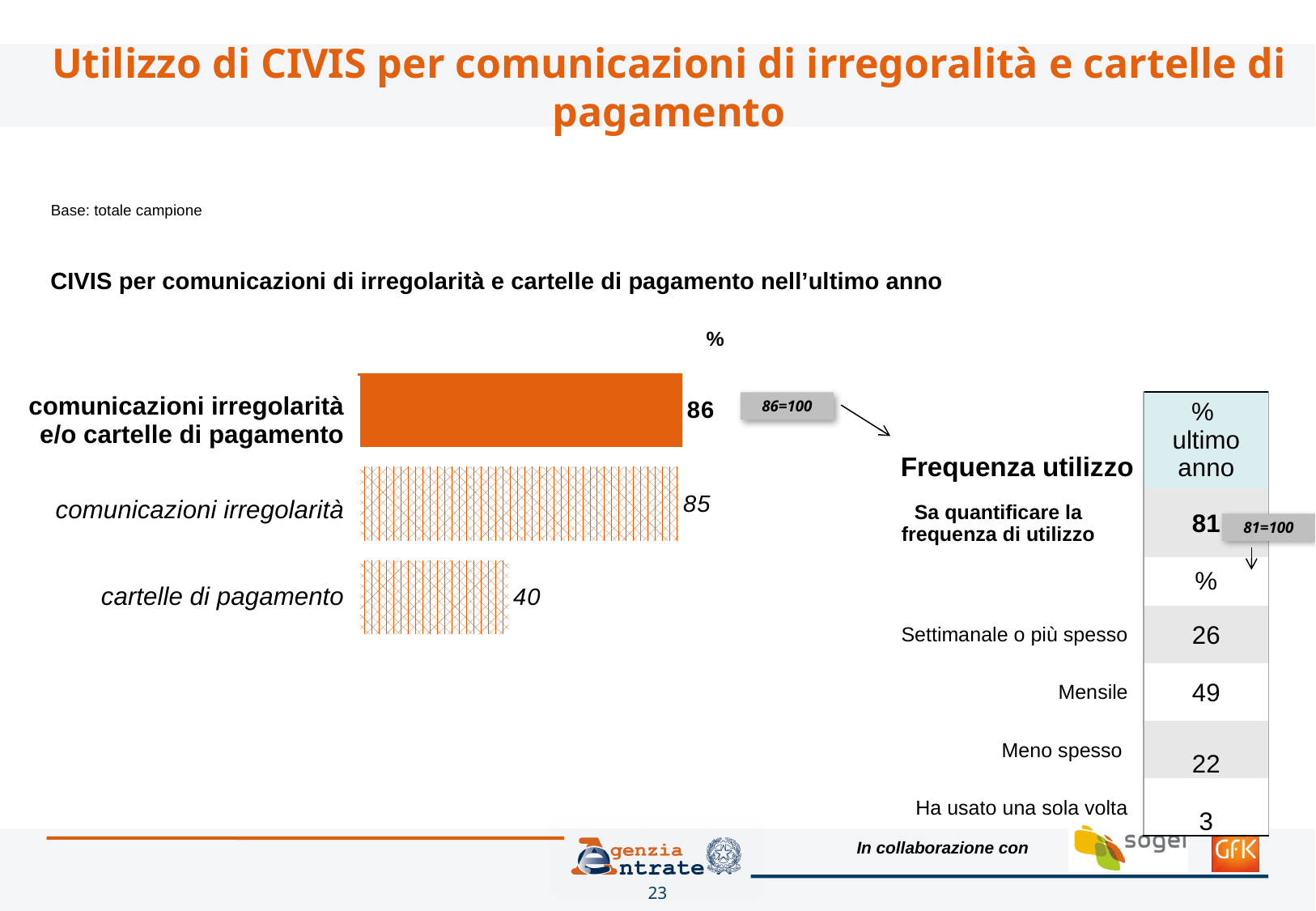
What is the value for "cartelle di pagamento" in the bar chart? 40 Which category has the highest value in the bar chart? comunicazioni irregolarità e/o cartelle di pagamento How many categories are shown in the bar chart? 3 Which is larger: the value for "comunicazioni irregolarità" or the value for "cartelle di pagamento"? comunicazioni irregolarità What is the difference between the values for "comunicazioni irregolarità" and "cartelle di pagamento"? 45 What is the value for "comunicazioni irregolarità" in the bar chart? 85 Which category has the lowest value in the bar chart? cartelle di pagamento What unit is indicated above the bars in the chart? % What kind of chart is shown on the slide? bar chart What is the difference between the values for "comunicazioni irregolarità e/o cartelle di pagamento" and "cartelle di pagamento"? 46 What is the value for "comunicazioni irregolarità e/o cartelle di pagamento" in the bar chart? 86 What is the title of the chart on the slide? CIVIS per comunicazioni di irregolarità e cartelle di pagamento nell'ultimo anno